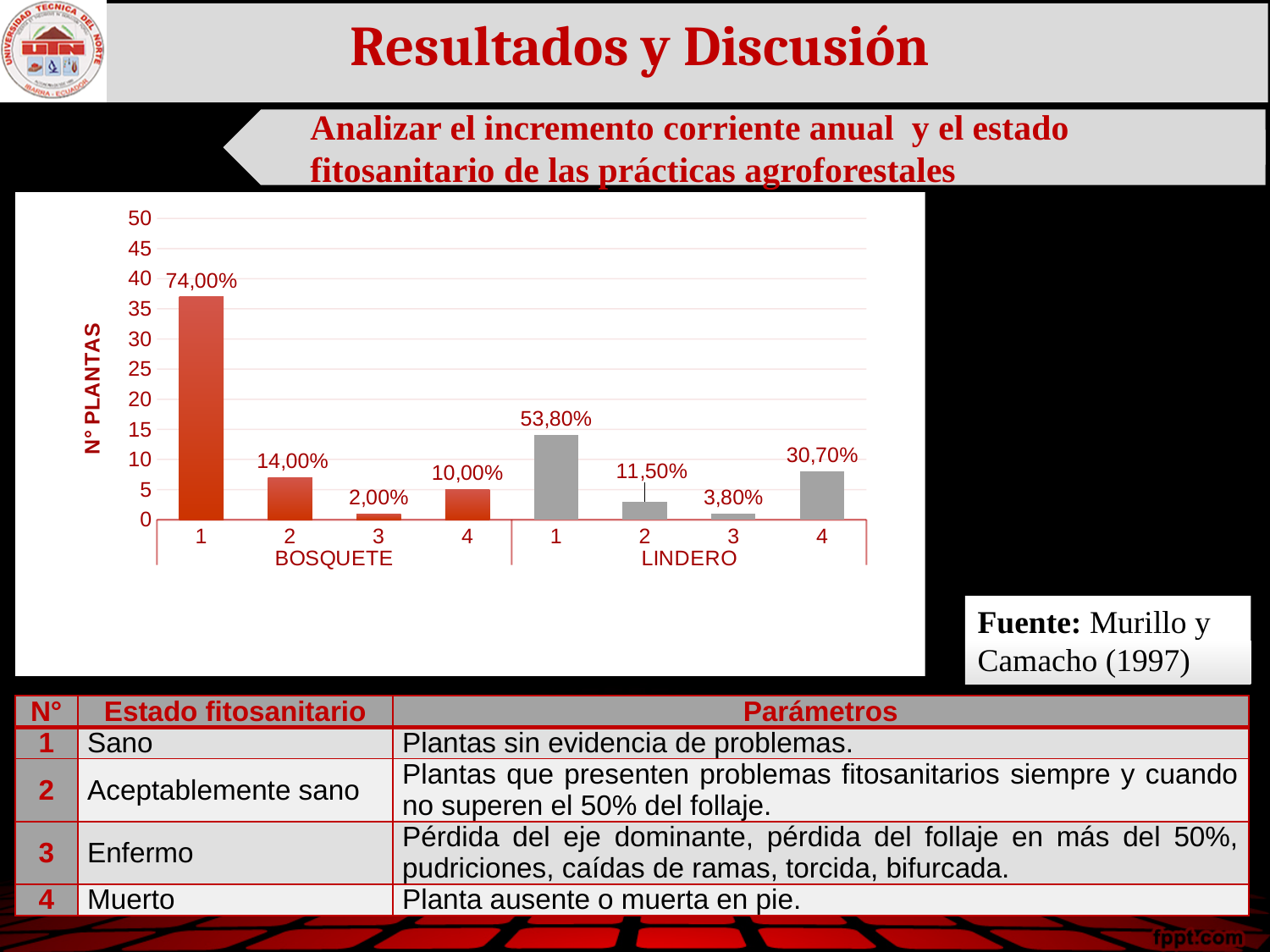
What data label is shown on the bar for category 4 under LINDERO? 30,70% What type of chart is shown on the slide? Bar chart What data label is shown on the bar for category 3 under BOSQUETE? 2,00% How many bars are plotted in the chart? 8 Within the LINDERO group, which category has the lowest bar? 3 Which bar is taller: BOSQUETE 2 or LINDERO 4? LINDERO 4 Which bar in the chart is the tallest? BOSQUETE 1 What data label is shown on the bar for category 1 under BOSQUETE? 74,00% What is the label of the vertical axis of the chart? N° PLANTAS Is the number of plants for BOSQUETE 1 greater or less than 35? greater What data label is shown on the bar for category 2 under LINDERO? 11,50%